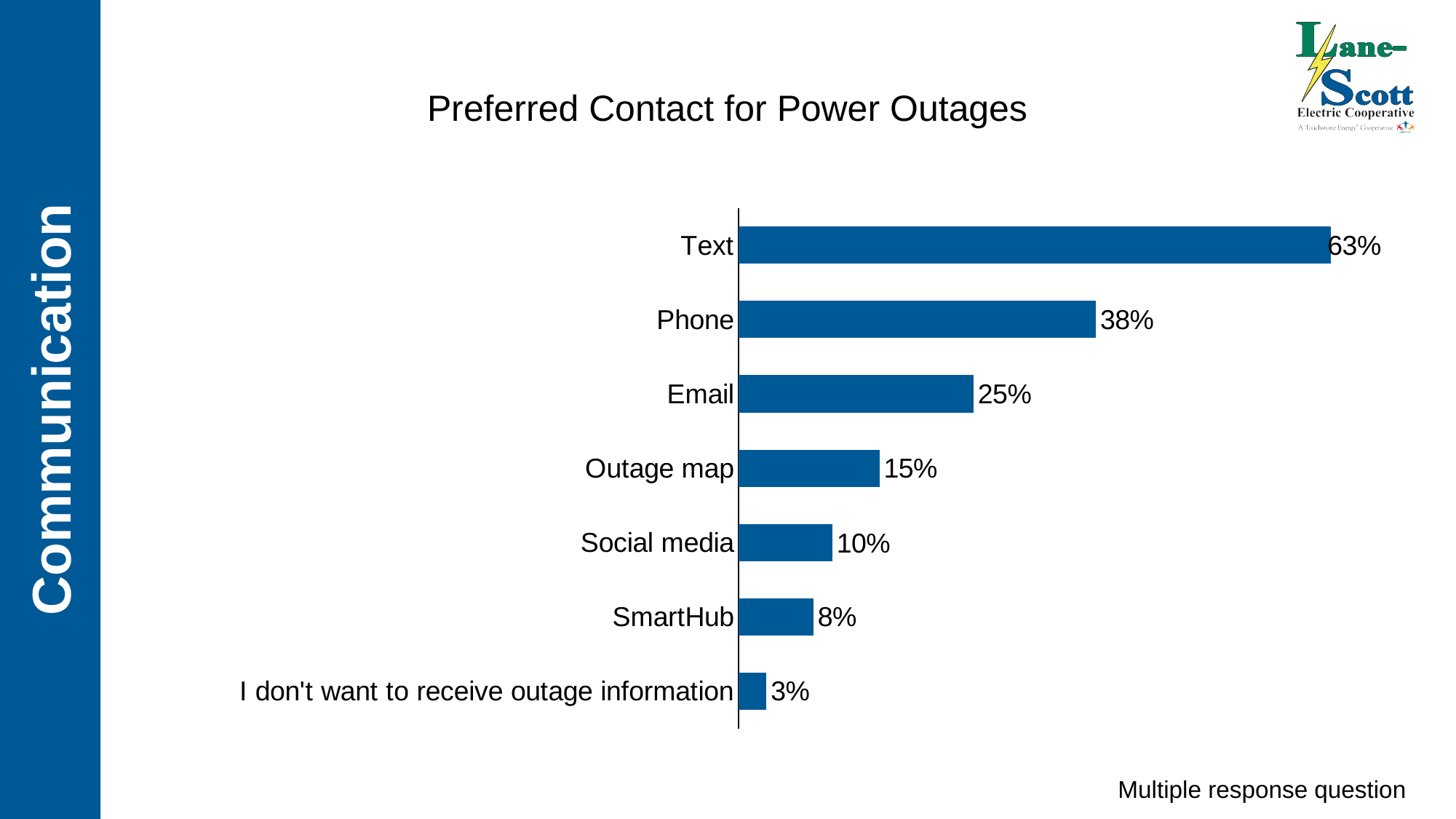
What is the value shown for Phone? 38% What percentage is shown for Outage map? 15% What is the value for SmartHub? 8% What is the difference between Email and Social media? 15% Which is larger, Outage map or Social media? Outage map Which category has the lowest percentage? I don't want to receive outage information What is the title of the chart? Preferred Contact for Power Outages How many categories are shown in the chart? 7 What type of chart is shown on the slide? Bar chart Which contact method has the highest percentage? Text What is the difference between the Text and Phone percentages? 25% What percentage of respondents prefer Text as contact for power outages? 63%